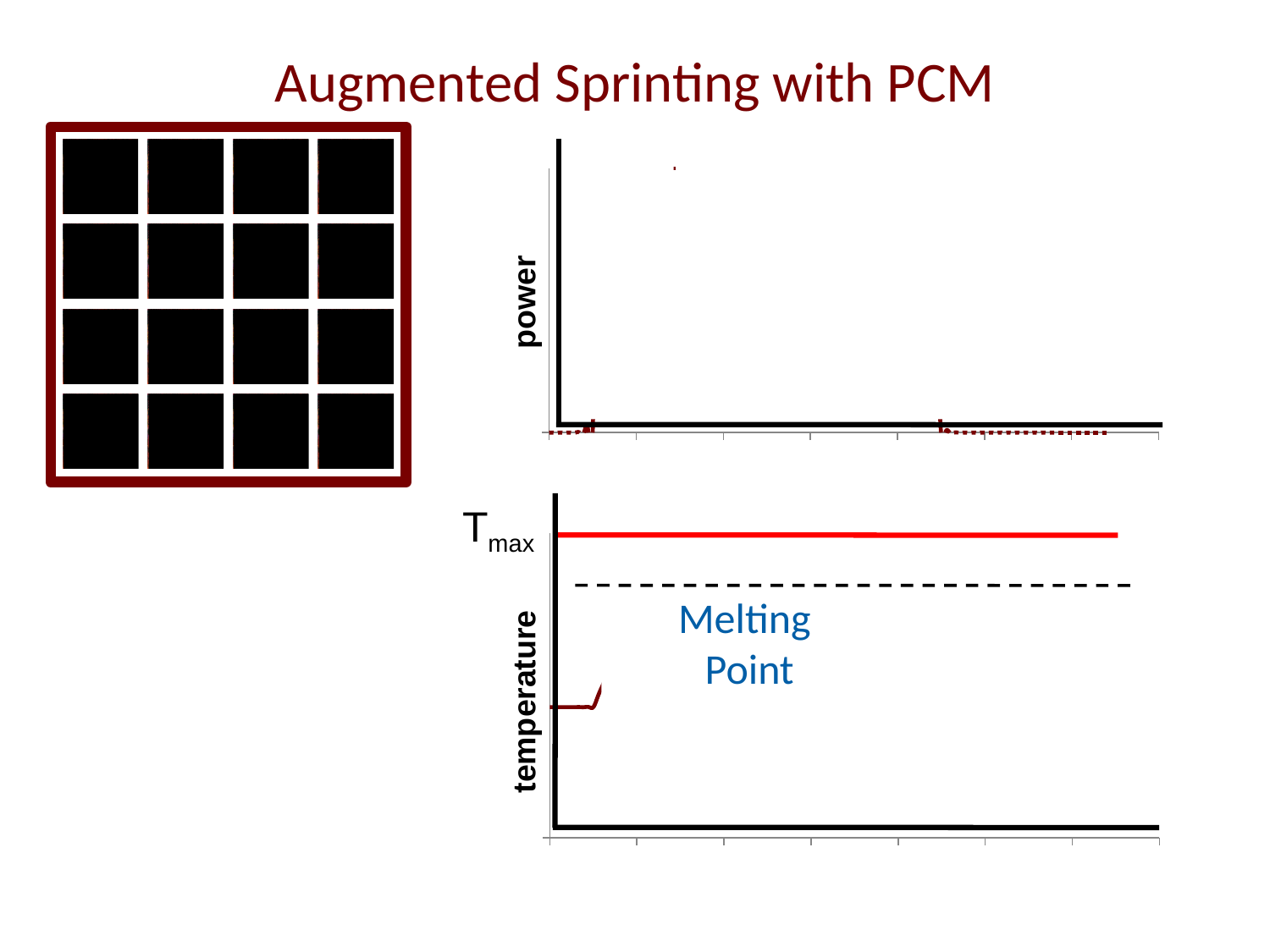
In the bottom chart, which is higher on the temperature axis: the Tmax line or the Melting Point line? Tmax How many charts are shown on the slide? 2 In the bottom chart, what does the dashed horizontal line represent? Melting Point What kind of chart is the top chart on the slide? line chart In the bottom chart, what label is given to the solid red horizontal line? Tmax What kind of chart is the bottom chart on the slide? line chart What is the y-axis label of the bottom chart? temperature